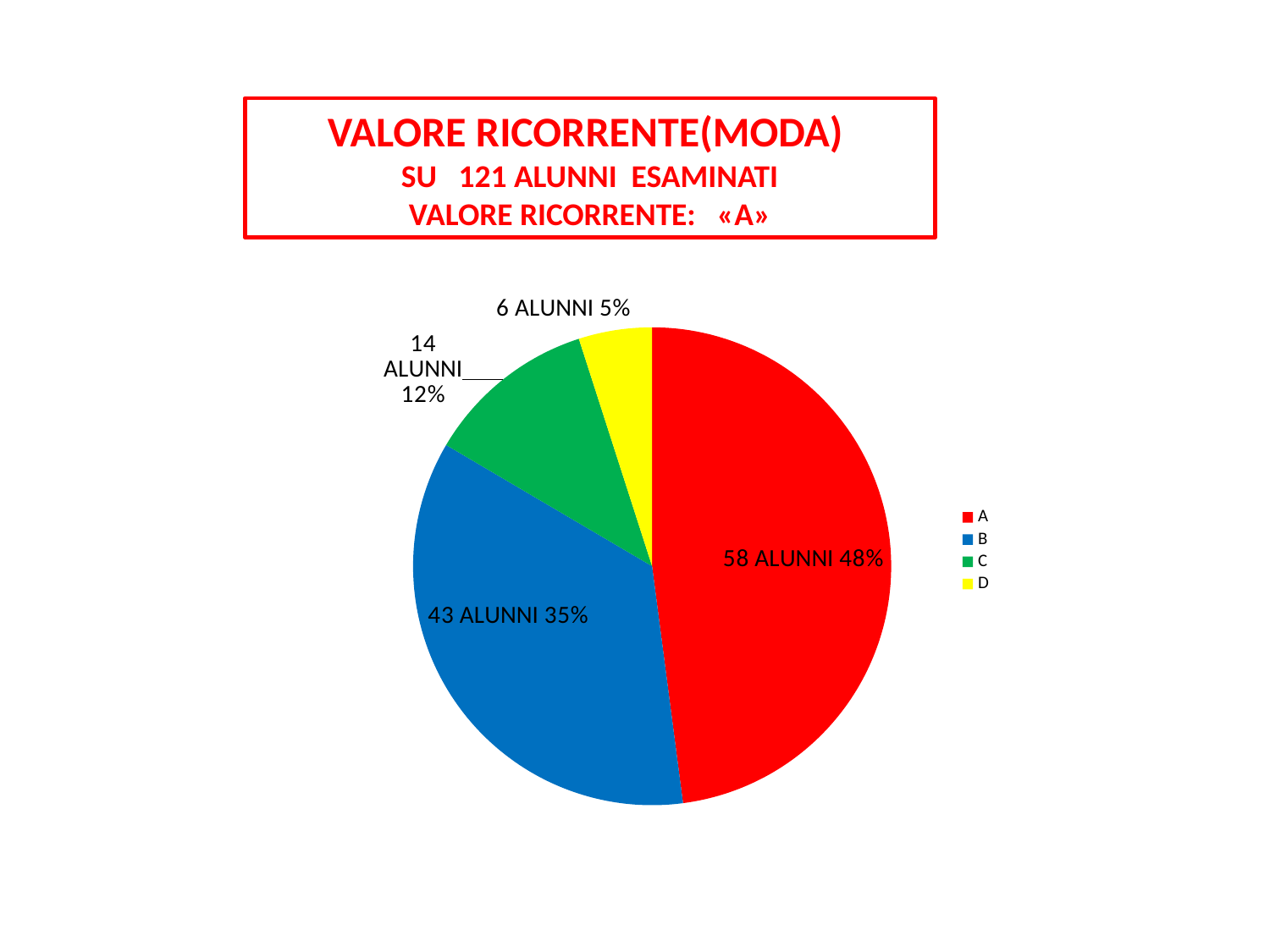
What percentage share does category D have? 5% How many students are in category C? 14 ALUNNI What percentage share does category B have? 35% Which category has the smallest slice? D According to the title box, how many students were examined in total? 121 What kind of chart is shown on the slide? pie chart Which has more students, category C or category D? C What colour is the slice for category B? blue What is the difference in number of students between category A and category B? 15 How many categories does the legend list? 4 How many students (alunni) are in category A? 58 ALUNNI Which category has the largest slice? A